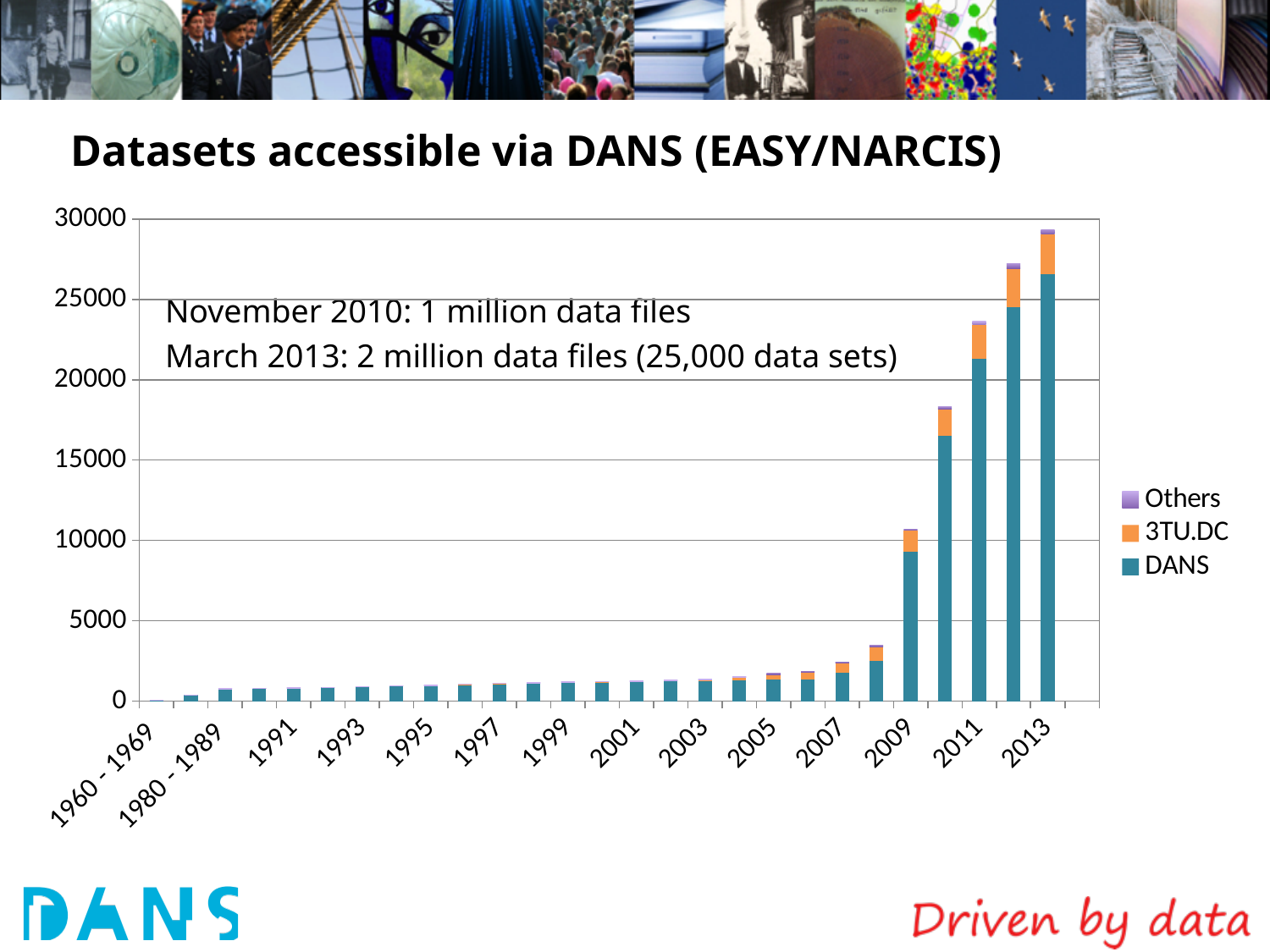
How many series does the legend list? 3 Which year has the tallest bar? 2013 Is the total for 2009 greater or less than 10000? greater Is the total for 2007 greater or less than 5000? less Do the bar totals generally rise or fall from left to right along the x axis? rise Is the total for 2011 greater or less than 20000? greater What is the title of the chart? Datasets accessible via DANS (EASY/NARCIS) Which series are listed in the legend? Others, 3TU.DC, DANS What kind of chart is shown on the slide? Stacked bar chart Which bar is taller, 2011 or 2013? 2013 Which series makes up the largest part of each stacked bar? DANS